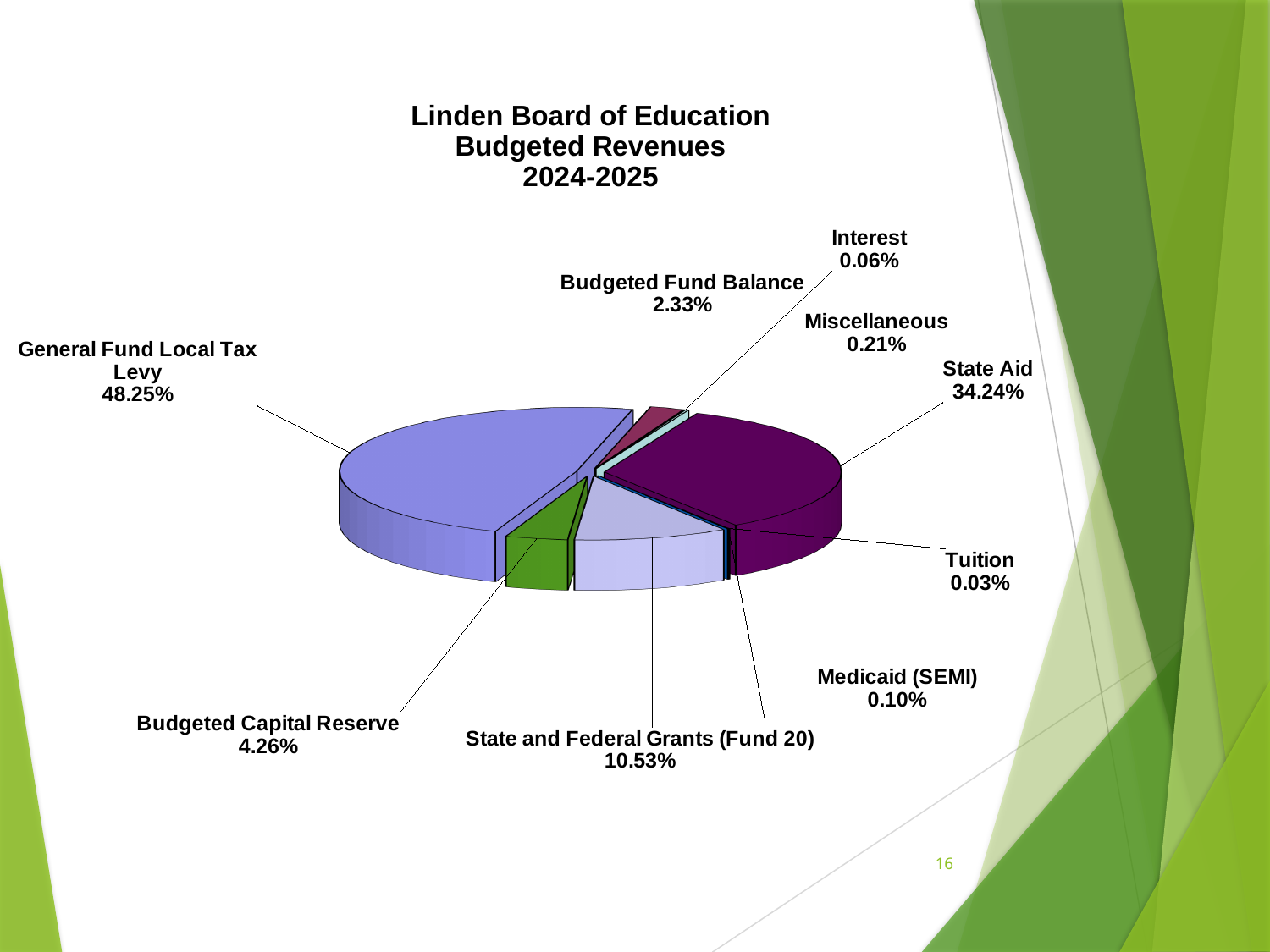
What share is shown for State and Federal Grants (Fund 20)? 10.53% What share of budgeted revenues comes from the General Fund Local Tax Levy? 48.25% How many slices does the pie chart have? 9 What percentage is shown for Budgeted Capital Reserve? 4.26% What percentage of budgeted revenues is State Aid? 34.24% What is the title of the chart? Linden Board of Education Budgeted Revenues 2024-2025 What kind of chart is shown on the slide? Pie chart Which revenue source has the largest share of the pie? General Fund Local Tax Levy Which revenue source has the smallest share of the pie? Tuition What percentage is shown for Tuition? 0.03% What is the difference in percentage points between the General Fund Local Tax Levy and State Aid? 14.01 Which is larger, Budgeted Fund Balance or Budgeted Capital Reserve? Budgeted Capital Reserve